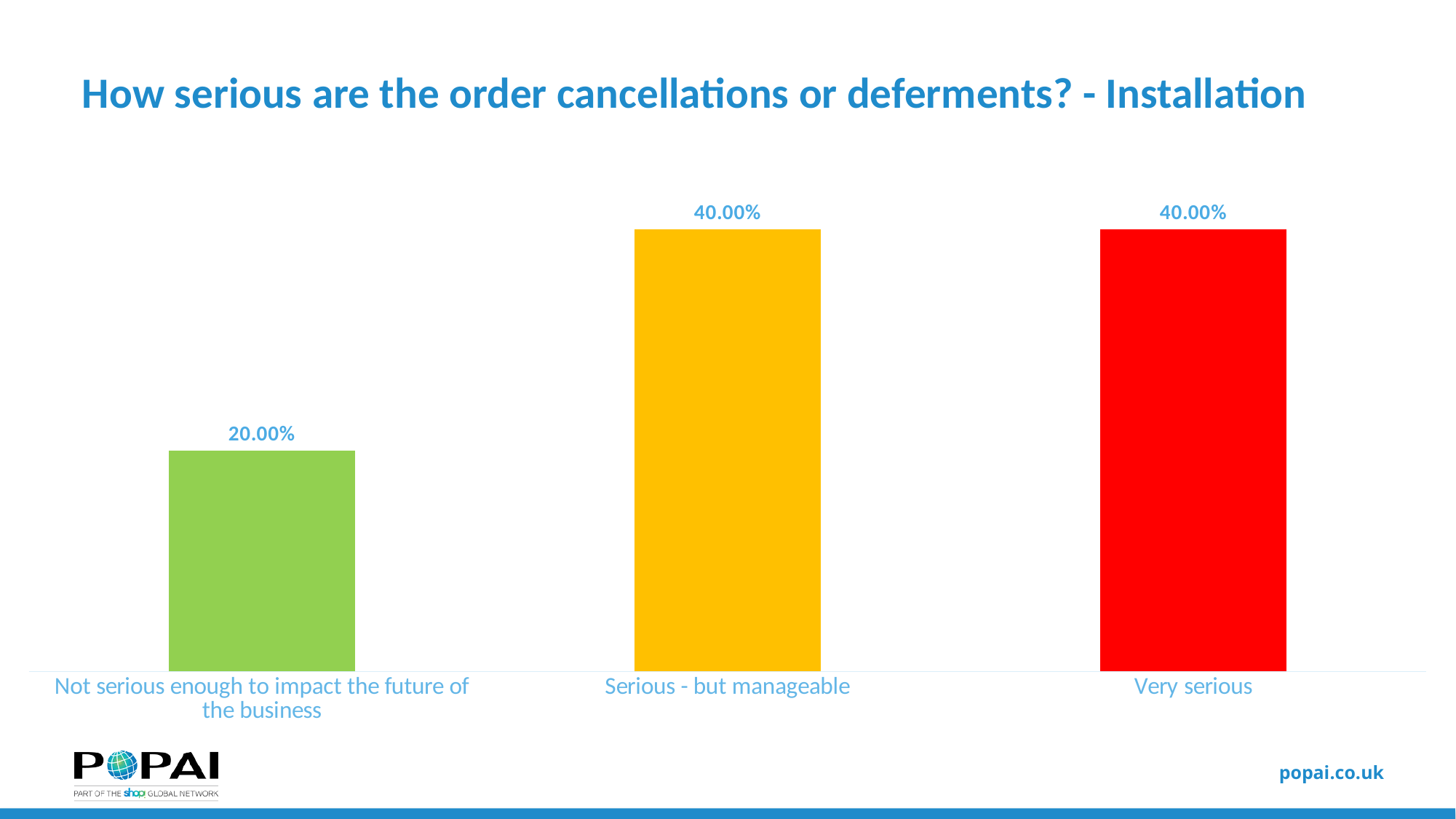
Which is larger, the value for "Serious - but manageable" or the value for "Not serious enough to impact the future of the business"? Serious - but manageable How many categories are shown in the chart? 3 Which category has the lowest value? Not serious enough to impact the future of the business What kind of chart is shown on the slide? Bar chart What colour is the bar for "Very serious"? Red What is the title of the chart? How serious are the order cancellations or deferments? - Installation What is the value for "Very serious"? 40.00% What is the value for "Serious - but manageable"? 40.00% What is the difference between the values for "Very serious" and "Not serious enough to impact the future of the business"? 20.00% Do "Serious - but manageable" and "Very serious" have the same value? Yes What is the value for "Not serious enough to impact the future of the business"? 20.00%